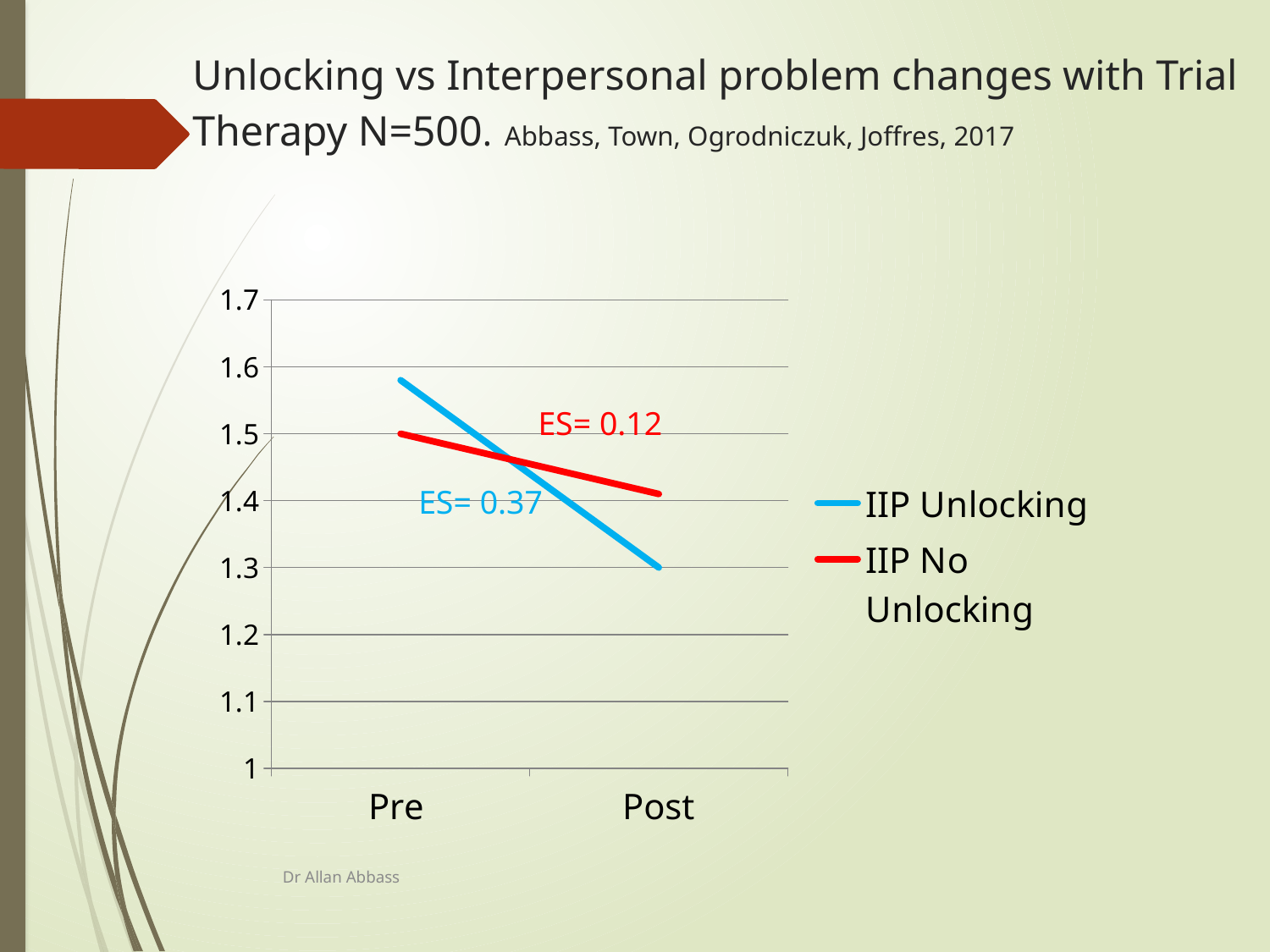
How many series does the legend list? 2 What kind of chart is shown on the slide? line chart At Post, which series has the higher value, IIP Unlocking or IIP No Unlocking? IIP No Unlocking What is the value for IIP No Unlocking at Pre? 1.5 Is the value for IIP No Unlocking at Post greater or less than 1.5? less What colour is the IIP No Unlocking line? red Is the value for IIP Unlocking at Pre greater or less than 1.5? greater At Pre, which series has the higher value, IIP Unlocking or IIP No Unlocking? IIP Unlocking Does the IIP No Unlocking line rise or fall from Pre to Post? fall Does the IIP Unlocking line rise or fall from Pre to Post? fall What effect size (ES) is labelled next to the IIP Unlocking line? ES= 0.37 How many points are there along the x axis? 2